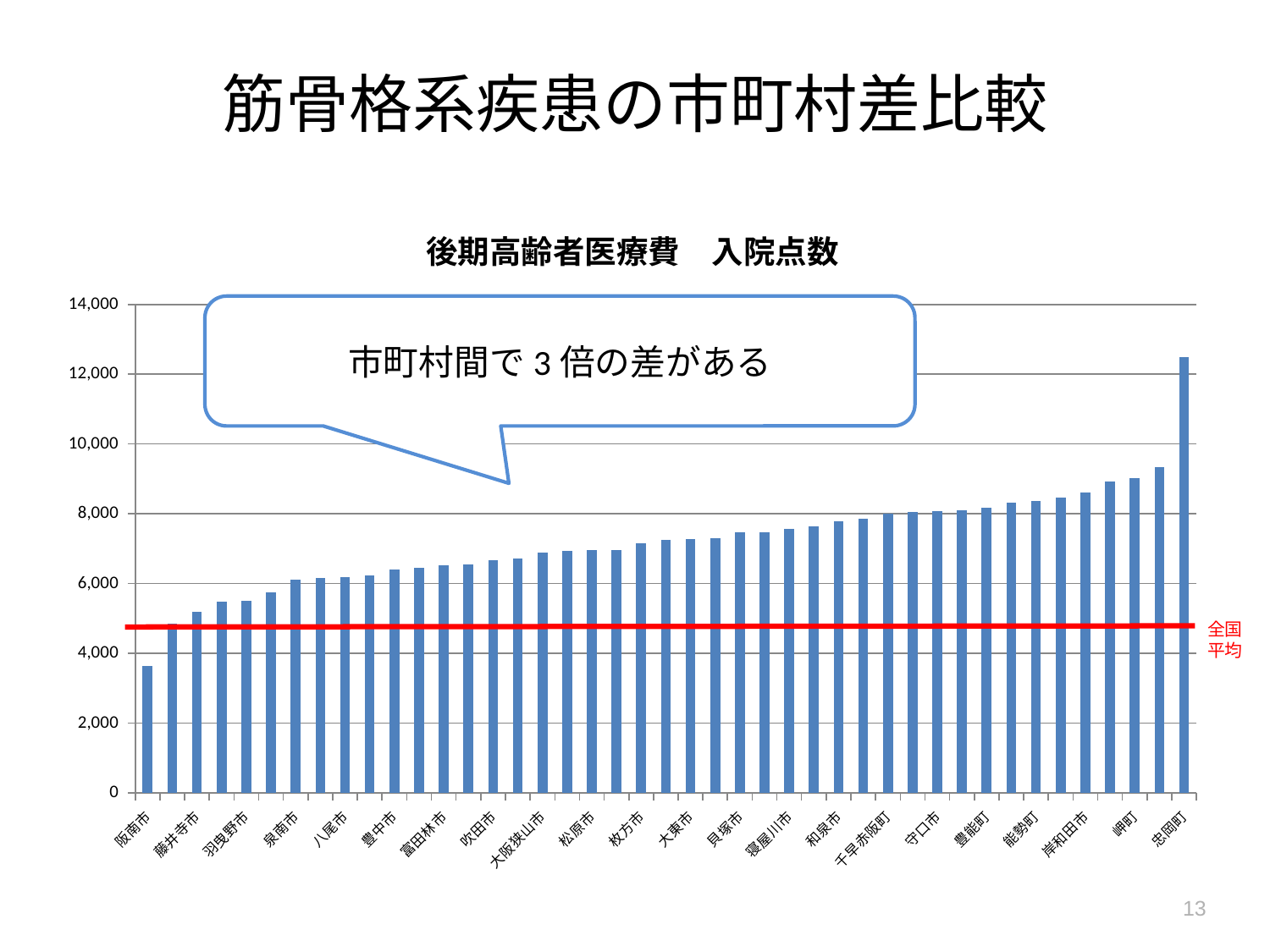
Is the value for 和泉市 greater or less than 8,000? less Do the bar values rise or fall from left to right along the x axis? rise Which has the larger value, 岬町 or 藤井寺市? 岬町 What is the title of the chart? 後期高齢者医療費 入院点数 Which municipality has the lowest bar in the chart? 阪南市 Is the value for 忠岡町 greater or less than 12,000? greater Which municipality has the highest bar in the chart? 忠岡町 Is the value for 阪南市 greater or less than 4,000? less What kind of chart is shown on the slide? bar chart What does the red horizontal line across the chart represent, according to its label? 全国平均